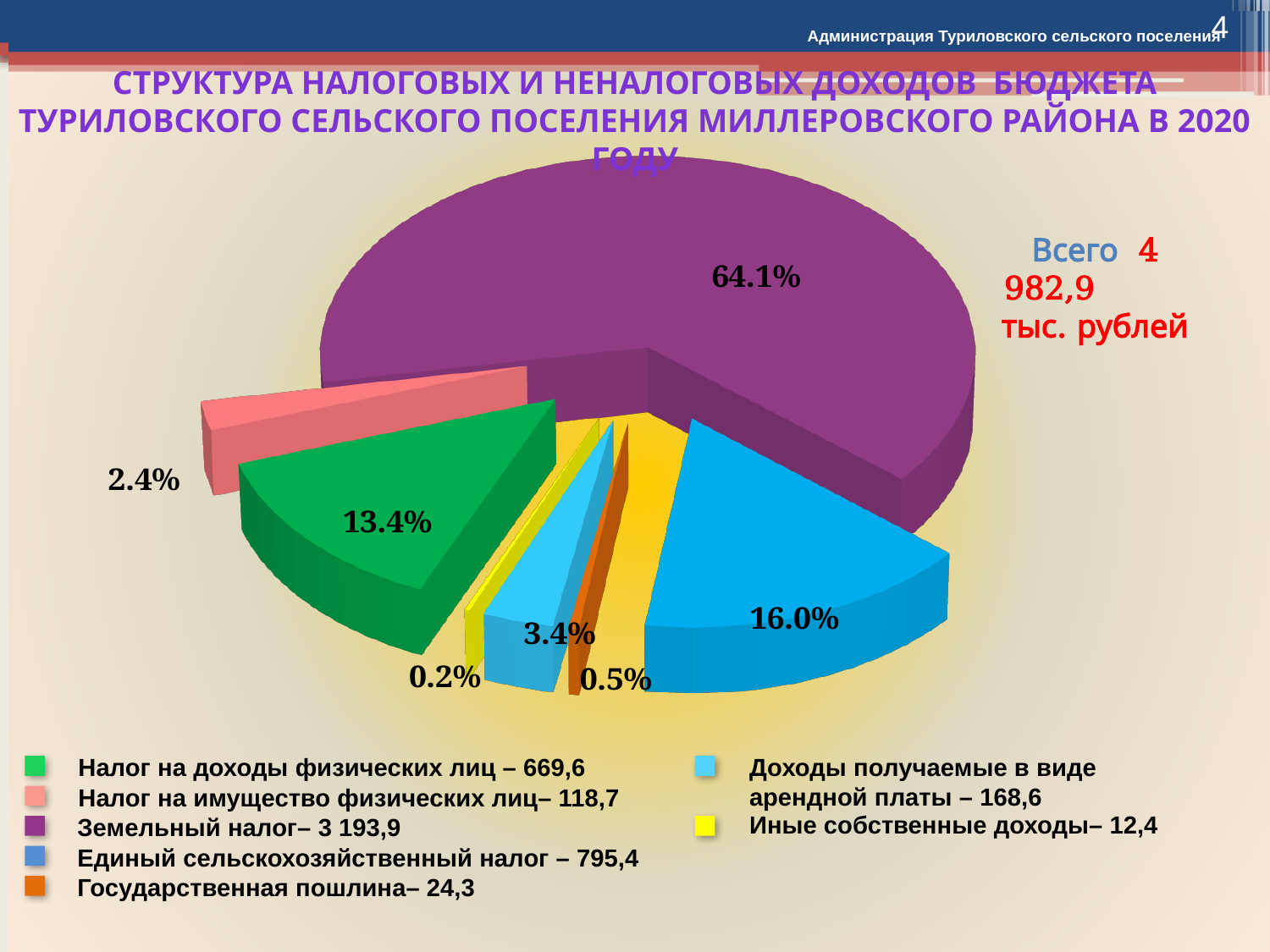
Which is larger: the share for Налог на имущество физических лиц or the share for Доходы получаемые в виде арендной платы? Доходы получаемые в виде арендной платы Which category has the smallest share of the pie? Иные собственные доходы Which category has the largest share of the pie? Земельный налог What share of the pie does Налог на доходы физических лиц (the green slice) take? 13.4% What kind of chart is shown on the slide? pie chart What is the difference in percentage points between the Земельный налог slice (64.1%) and the Единый сельскохозяйственный налог slice (16.0%)? 48.1 According to the legend, what is the value for Государственная пошлина? 24,3 How many entries does the legend list? 7 How many slices does the pie chart have? 7 What share of the pie does Земельный налог (the purple slice) take? 64.1% What total amount (Всего) is stated on the slide? 4 982,9 тыс. рублей What share of the pie does Единый сельскохозяйственный налог (the blue slice) take? 16.0%